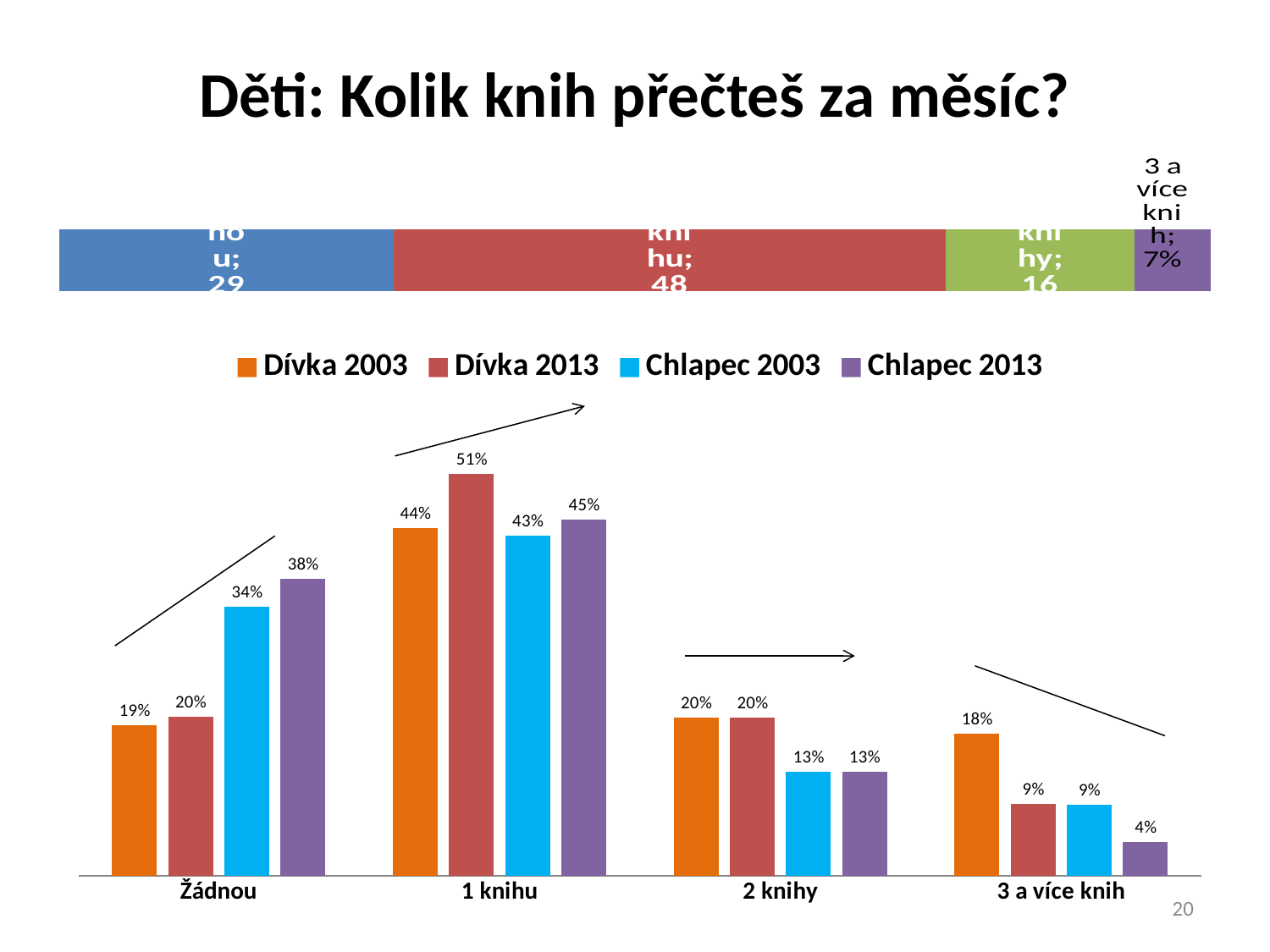
In the bottom bar chart, what is the value for Dívka 2013 in the '1 knihu' category? 51% How many categories are shown on the x axis of the bottom bar chart? 4 In the bottom bar chart, which category has the highest value for Dívka 2003? 1 knihu How many series does the legend of the bottom bar chart list? 4 In the top stacked bar chart, what percentage is shown for the '3 a více knih' segment? 7% In the bottom bar chart, what is the value for Chlapec 2013 in the '3 a více knih' category? 4% What are the legend entries of the bottom bar chart? Dívka 2003, Dívka 2013, Chlapec 2003, Chlapec 2013 In the bottom bar chart, what is the value for Chlapec 2003 in the '1 knihu' category? 43% In the bottom bar chart, which is larger in the '2 knihy' category: Dívka 2003 or Chlapec 2003? Dívka 2003 What kind of chart is the bottom chart on the slide? Bar chart In the bottom bar chart, which category has the lowest value for Chlapec 2013? 3 a více knih In the bottom bar chart, what is the difference between Chlapec 2013 and Chlapec 2003 in the 'Žádnou' category? 4 percentage points